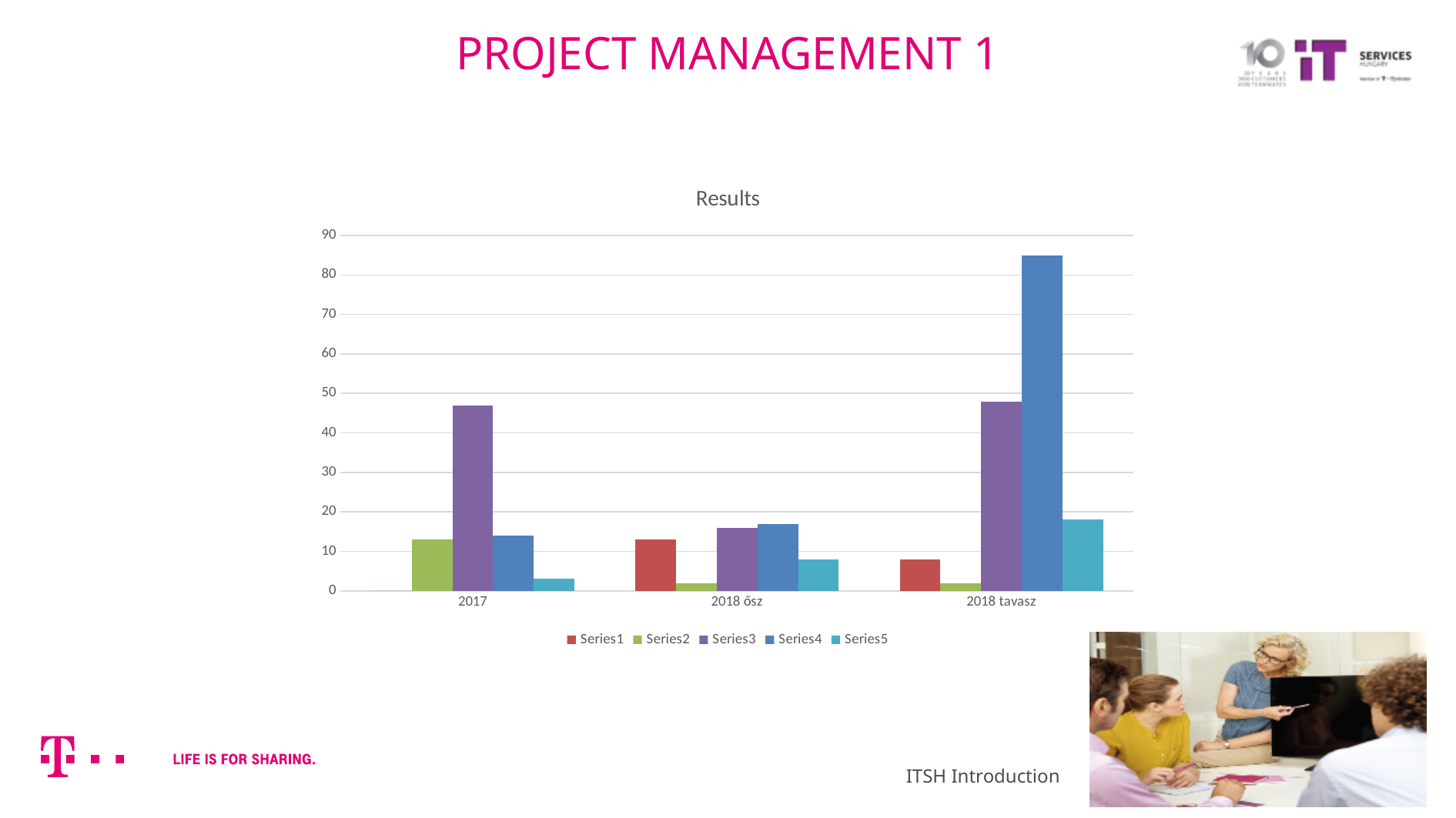
How many categories are shown on the x axis? 3 What type of chart is shown on the slide? bar chart How many series does the legend list? 5 Is the value for Series3 in 2017 greater or less than 40? greater Does the value for Series4 rise or fall from 2017 to 2018 tavasz? rise In 2017, which is larger: Series3 or Series5? Series3 Is the value for Series4 in 2018 tavasz greater or less than 80? greater In 2018 tavasz, which is larger: Series3 or Series4? Series4 What is the title of the chart? Results Which category contains the tallest bar in the chart? 2018 tavasz Is the value for Series5 in 2017 greater or less than 10? less Which series has the lowest bar in 2018 ősz? Series2